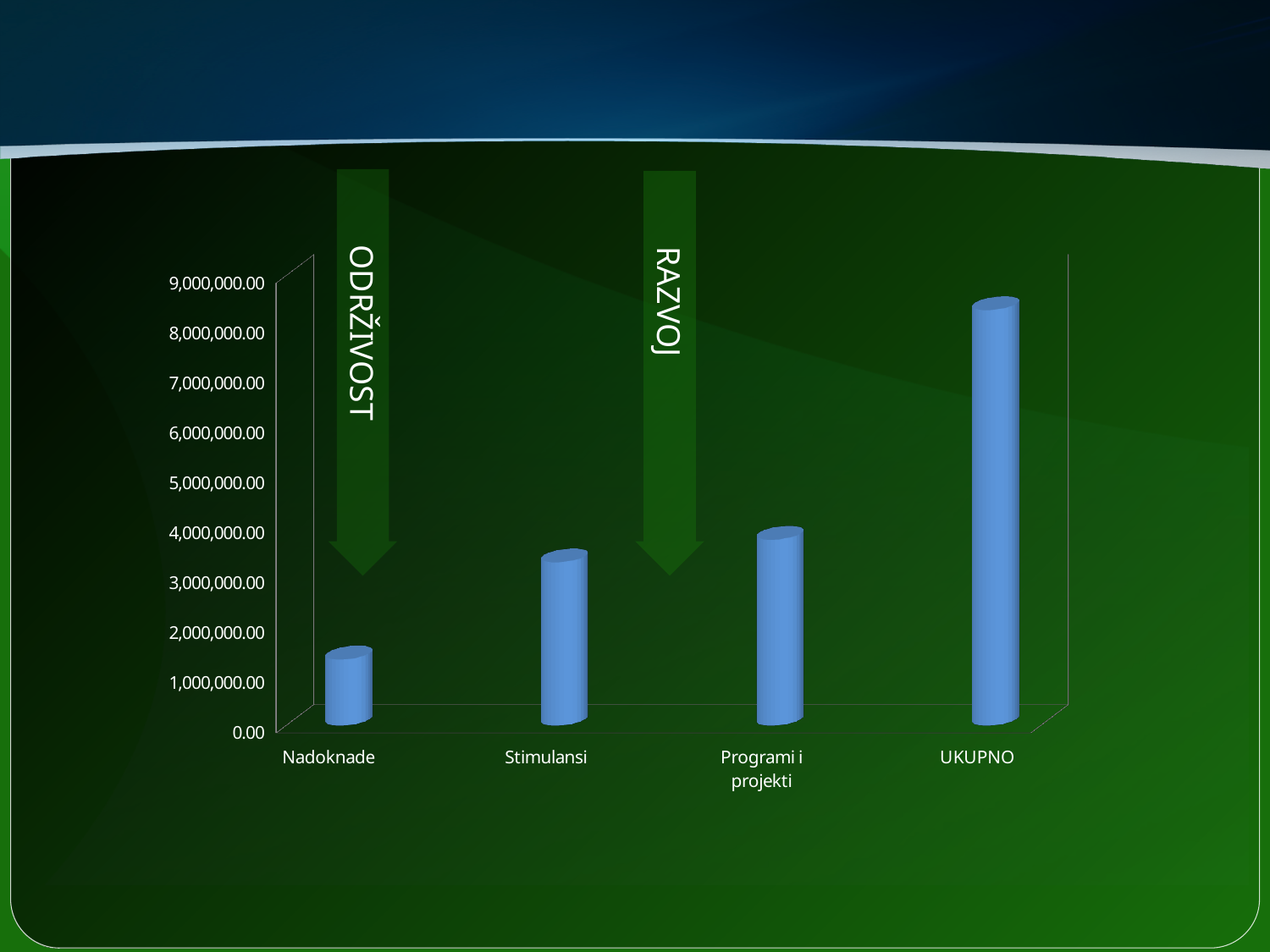
Is the value for Programi i projekti greater or less than 3,000,000.00? greater Is the value for Stimulansi greater or less than 4,000,000.00? less Which category has the highest value in the chart? UKUPNO What are the two labels written on the green arrows above the chart? ODRŽIVOST and RAZVOJ How many categories are shown on the x axis of the chart? 4 Is the value for Nadoknade greater or less than 2,000,000.00? less Do the bar values rise or fall from left to right along the x axis? rise Which is larger, the value for Nadoknade or the value for Stimulansi? Stimulansi Which category has the lowest value in the chart? Nadoknade What kind of chart is shown on the slide? bar chart